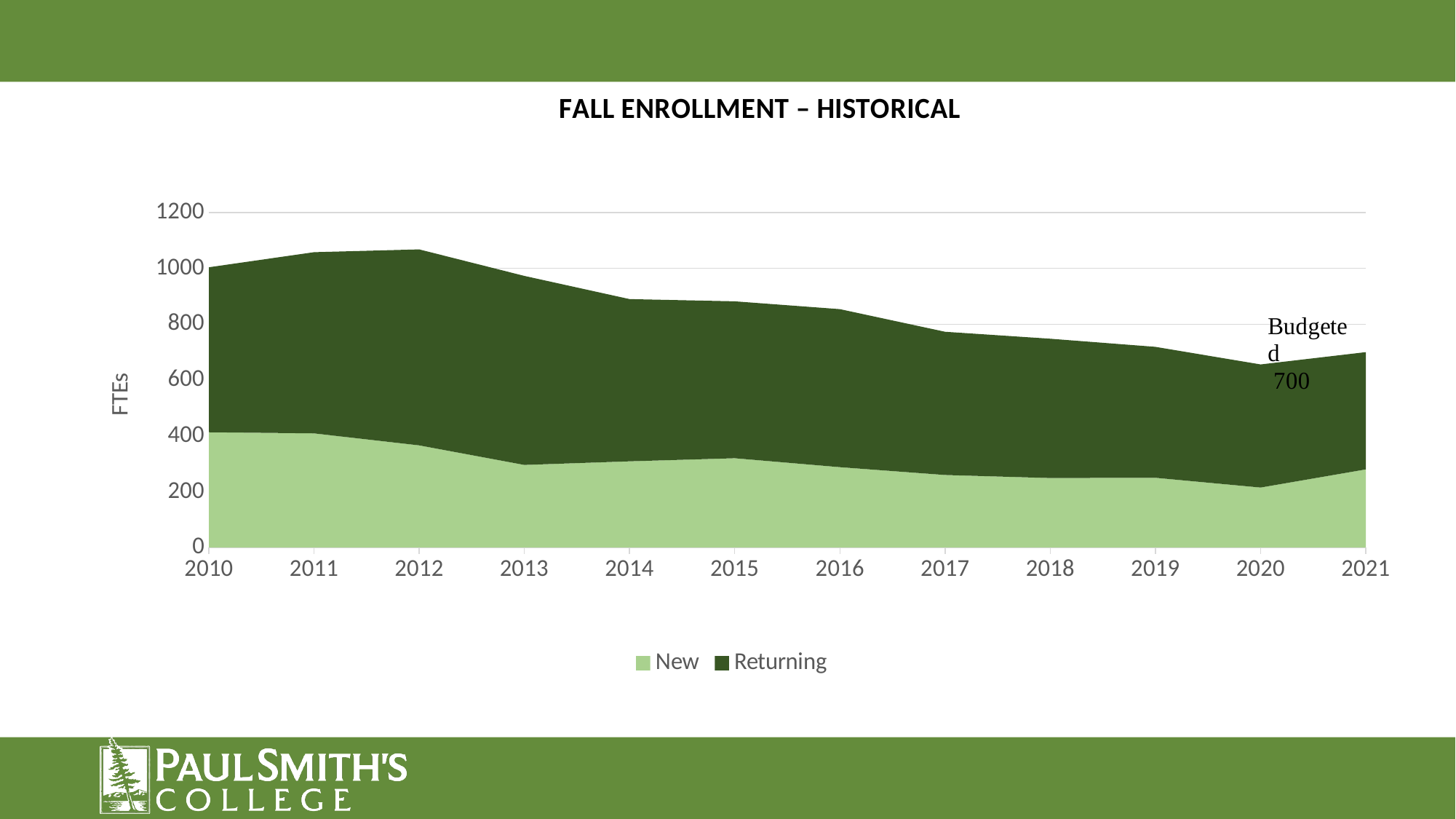
In which year is total enrollment (New plus Returning) lowest? 2020 In which year is the New series lowest? 2020 What is the title of the chart? FALL ENROLLMENT – HISTORICAL How many years are shown along the x axis? 12 How many series does the legend list? 2 Does total enrollment generally rise or fall from 2012 to 2020? Fall What kind of chart is shown on the slide? Stacked area chart Is the total enrollment in 2020 greater or less than 800? less What is the label on the vertical axis? FTEs Is the total enrollment in 2012 greater or less than 1000? greater Is the value for New in 2013 greater or less than 400? less What budgeted value is annotated near 2021? 700